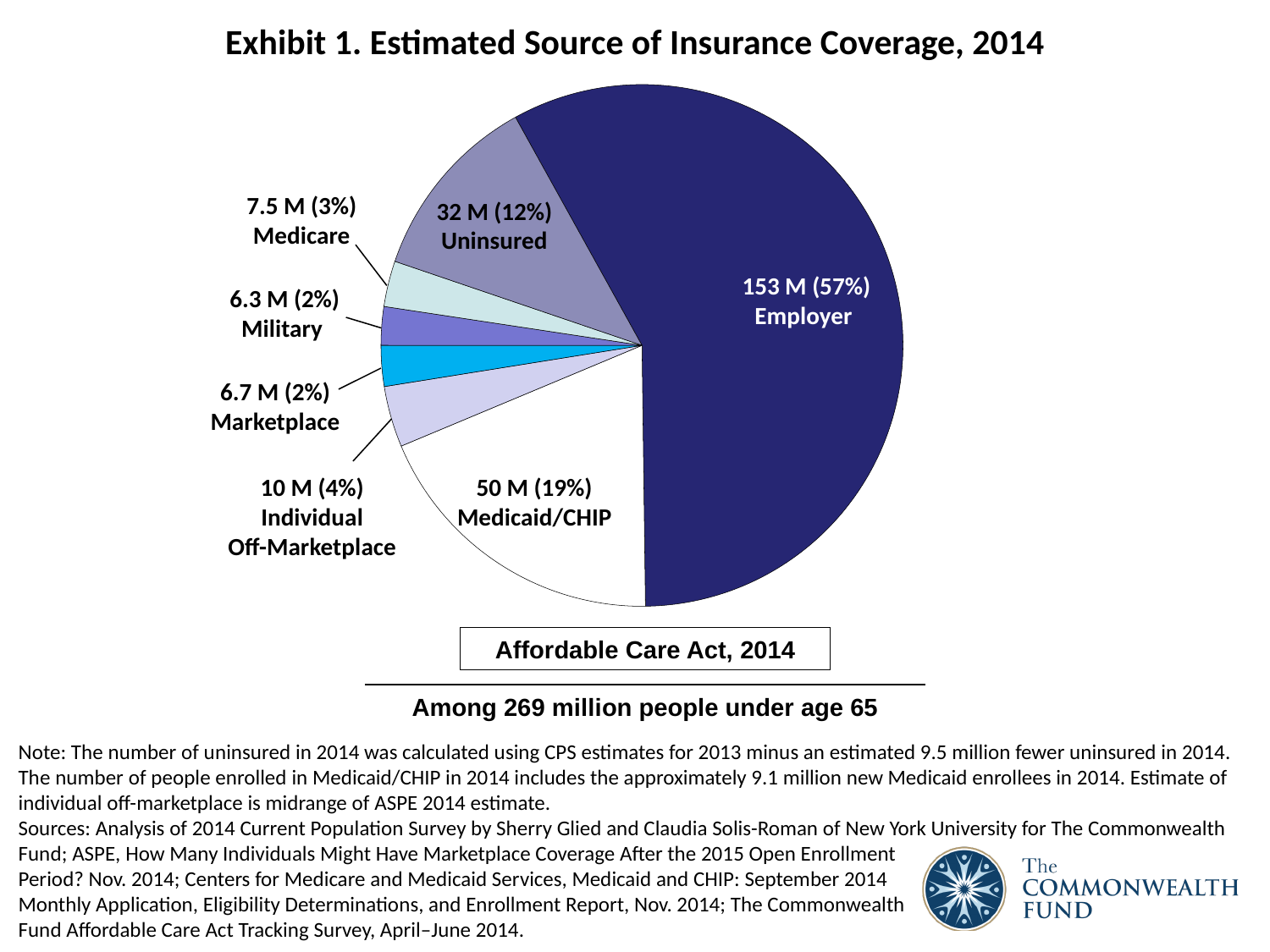
Which source of coverage has the smallest slice of the pie? Military What is the value shown for Uninsured? 32 M (12%) Which is larger, the Marketplace slice or the Individual Off-Marketplace slice? Individual Off-Marketplace How many people are estimated to have Employer coverage in 2014? 153 M What percentage of people under age 65 are covered by Medicare according to the chart? 3% What share of the pie does Medicaid/CHIP represent? 19% What is the title of the chart? Exhibit 1. Estimated Source of Insurance Coverage, 2014 What is the difference in millions between Medicare and Military coverage? 1.2 M What kind of chart is shown on the slide? Pie chart Which source of coverage has the largest slice of the pie? Employer How many slices does the pie chart have? 7 What is the difference in millions between Employer coverage and Medicaid/CHIP coverage? 103 M